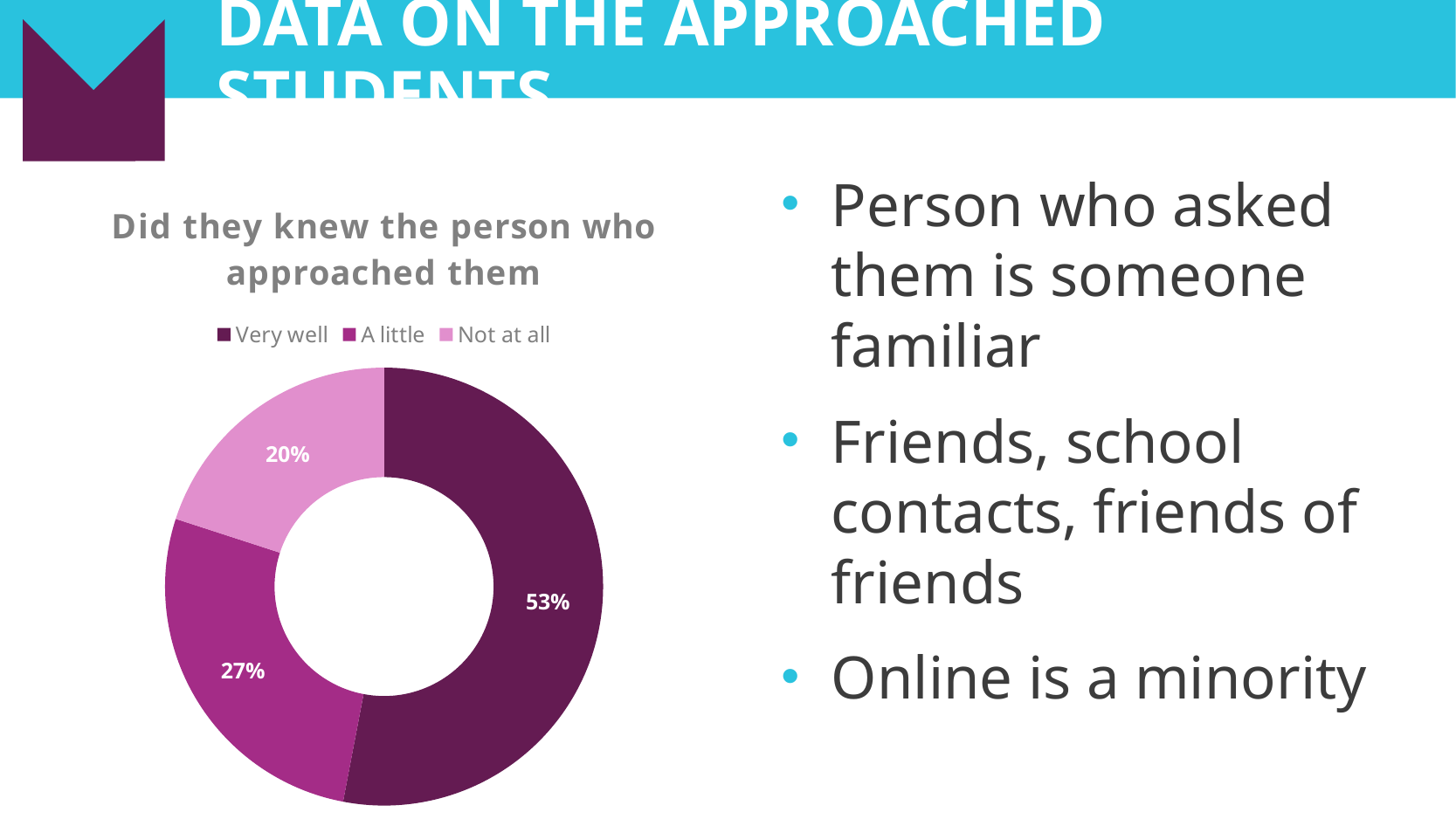
What percentage of students knew the person who approached them a little? 27% How many categories are shown in the chart? 3 Which category has the smallest share of the chart? Not at all Which is larger, the share for 'A little' or the share for 'Not at all'? A little What percentage of students did not know the person who approached them at all? 20% What is the difference in percentage points between 'A little' and 'Not at all'? 7 Which legend entry is shown in the lightest pink colour? Not at all What is the title of the chart? Did they knew the person who approached them What kind of chart is shown on the slide? Doughnut (pie) chart What percentage of students knew the person who approached them very well? 53% Which category has the largest share of the chart? Very well What is the difference in percentage points between 'Very well' and 'Not at all'? 33